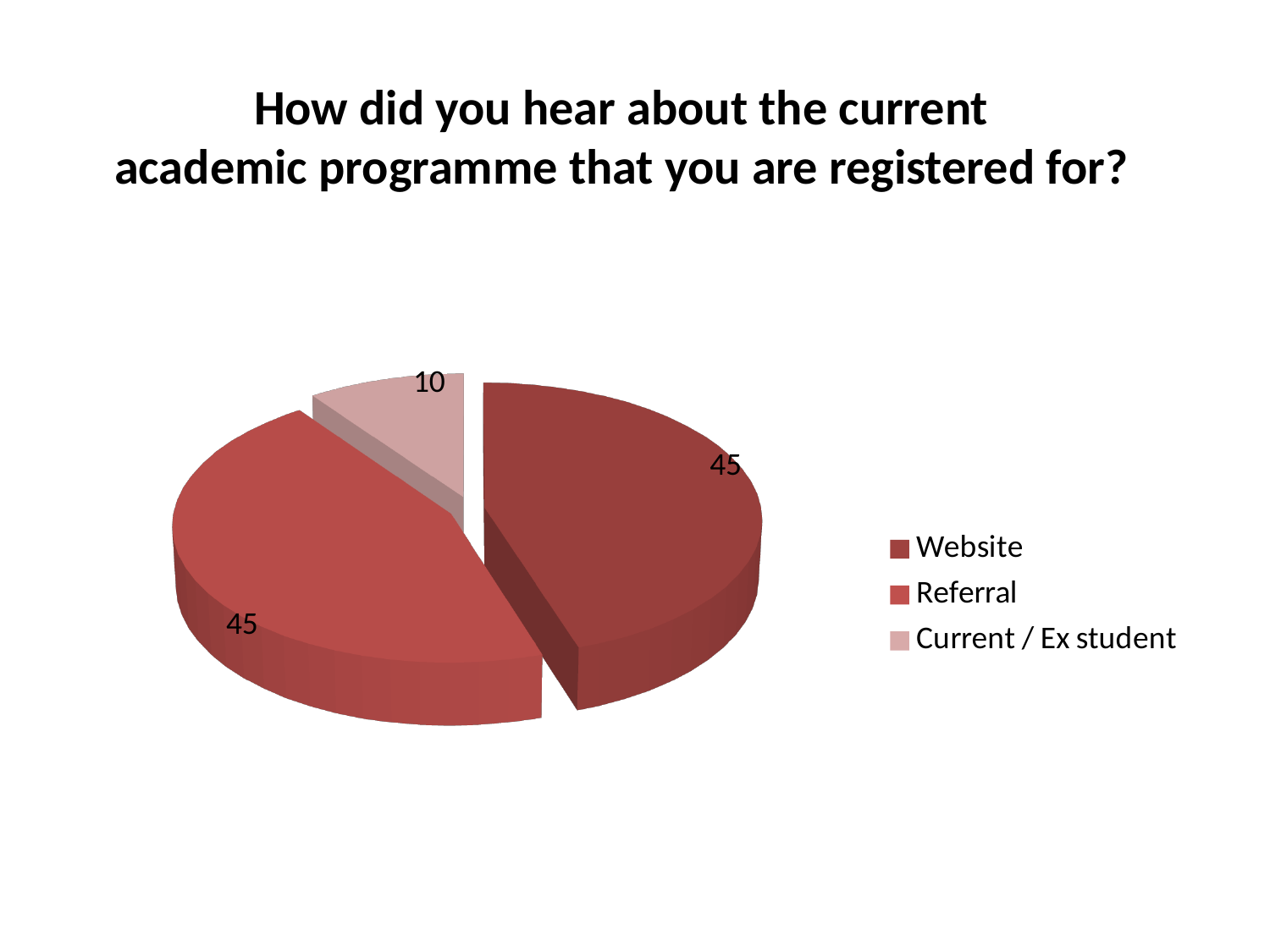
What share of the pie does the Website slice represent? 45% What is the difference between the values for Website and Current / Ex student? 35 What is the value for Website? 45 What share of the pie does the Current / Ex student slice represent? 10% Which is larger, the value for Referral or the value for Current / Ex student? Referral What is the value for Current / Ex student? 10 Which category has the smallest slice? Current / Ex student What is the value for Referral? 45 What is the title of the chart? How did you hear about the current academic programme that you are registered for? What kind of chart is shown on the slide? Pie chart How many entries does the legend list? 3 How many slices does the pie chart have? 3